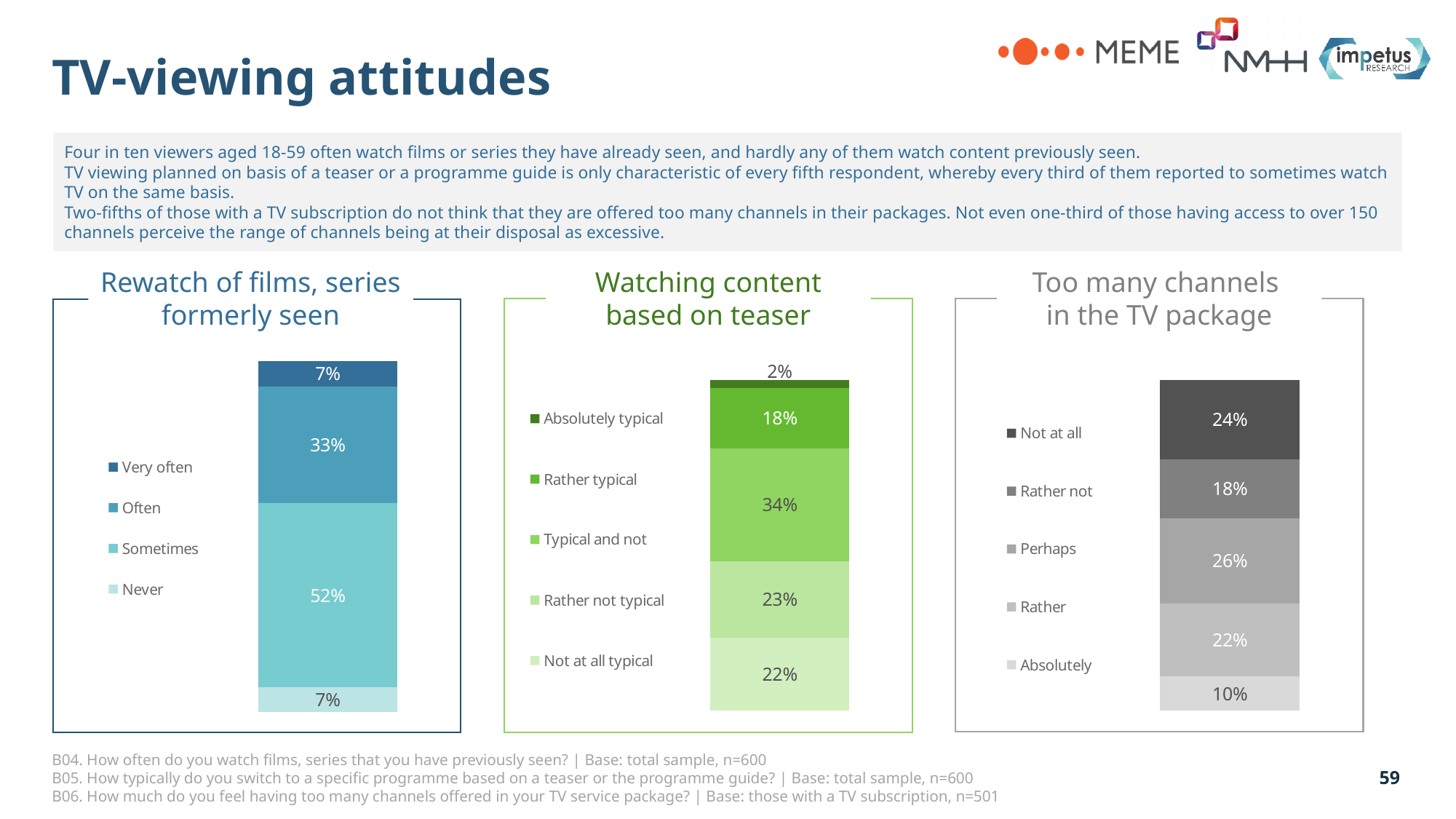
In the 'Rewatch of films, series formerly seen' chart, which response category has the largest share? Sometimes In the 'Watching content based on teaser' chart, what is the difference between 'Rather not typical' and 'Rather typical'? 5 percentage points In the 'Rewatch of films, series formerly seen' chart, what percentage of respondents answered 'Sometimes'? 52% In the 'Rewatch of films, series formerly seen' chart, what percentage answered 'Often'? 33% In the 'Watching content based on teaser' chart, what percentage is 'Typical and not'? 34% In the 'Watching content based on teaser' chart, what percentage is 'Absolutely typical'? 2% How many response categories does the legend of the 'Too many channels in the TV package' chart list? 5 In the 'Watching content based on teaser' chart, which response category has the smallest share? Absolutely typical In the 'Too many channels in the TV package' chart, what percentage answered 'Perhaps'? 26% What type of chart is used for 'Rewatch of films, series formerly seen'? Stacked bar chart In the 'Too many channels in the TV package' chart, which is larger, 'Not at all' or 'Rather'? Not at all In the 'Too many channels in the TV package' chart, what is the combined share of 'Not at all' and 'Rather not'? 42%